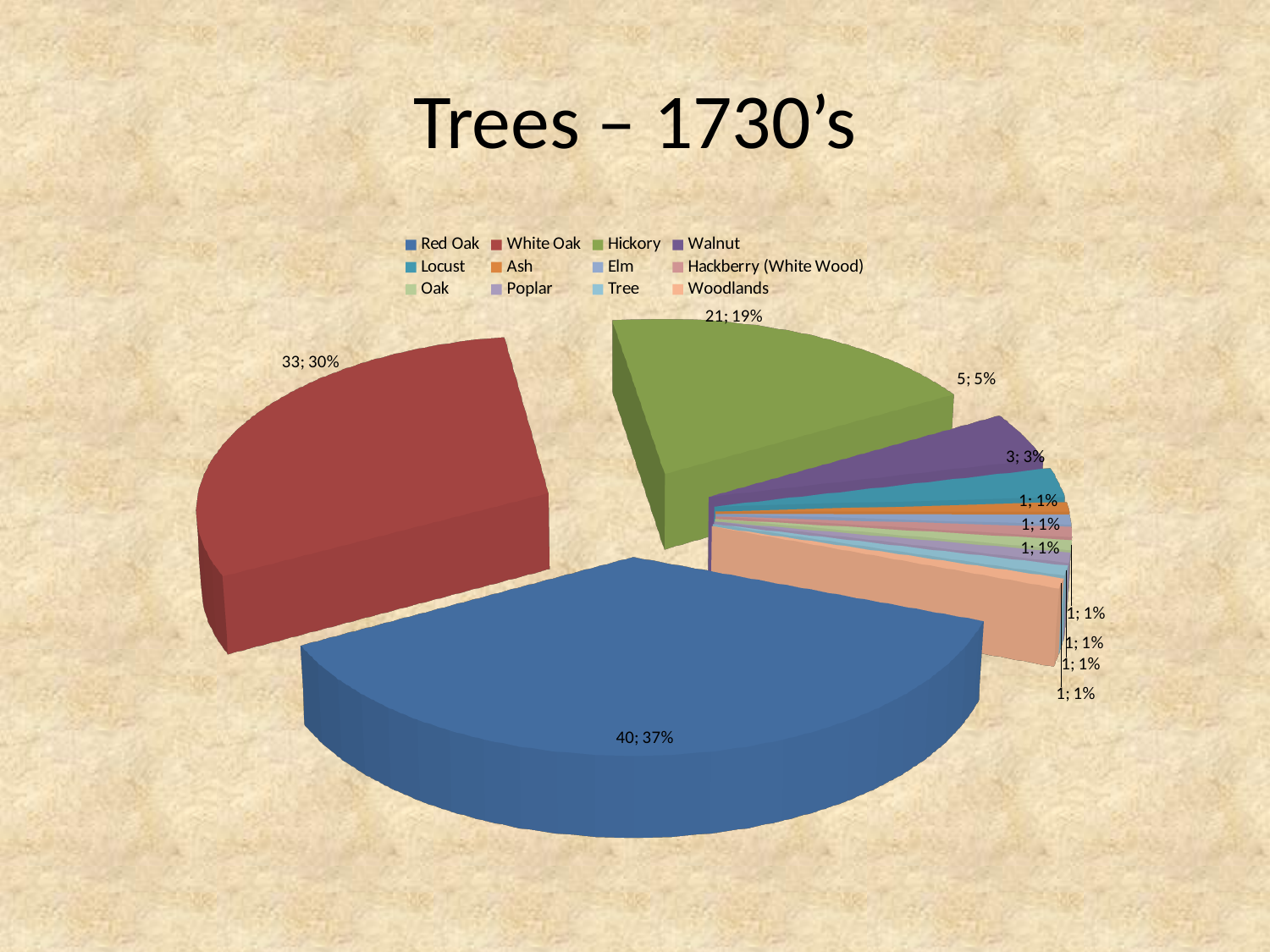
How many categories does the legend list? 12 Which is larger, the value for Hickory or the value for Walnut? Hickory What share of the pie does Red Oak represent? 37% What is the value for Red Oak? 40 What is the value for Hickory? 21 What is the value for White Oak? 33 Which category has the largest slice? Red Oak What is the difference between the values for Red Oak and White Oak? 7 What is the title of the chart? Trees – 1730's What kind of chart is shown on the slide? pie chart What share of the pie does Hickory represent? 19% What is the value for Walnut? 5